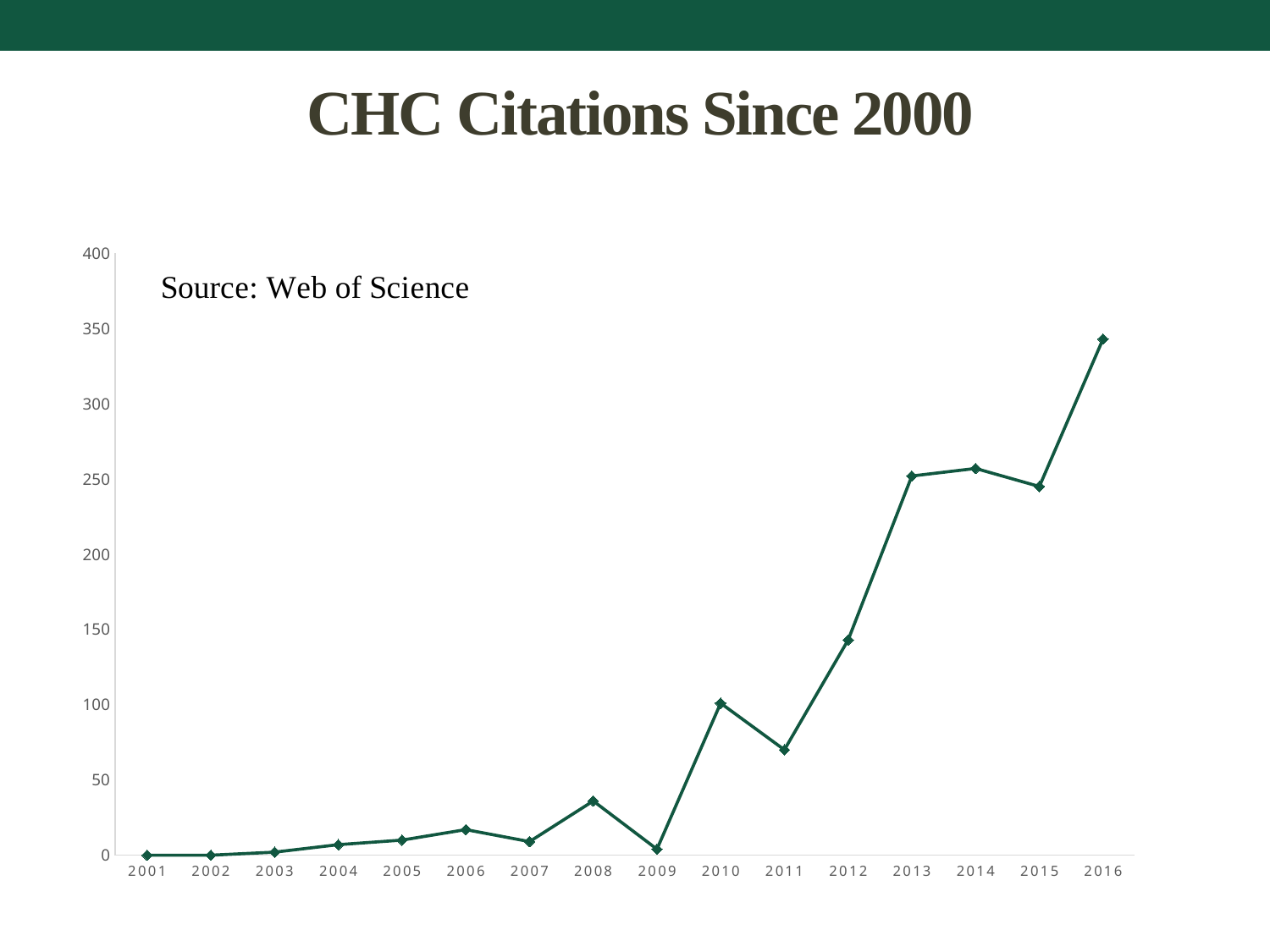
What source is cited on the chart? Web of Science Do citations generally rise or fall from 2001 to 2016? rise Is the value for 2013 greater or less than 200? greater Is the value for 2009 greater or less than 50? less How many years are plotted on the x axis? 16 Which year has more citations, 2010 or 2011? 2010 Is the value for 2011 greater or less than 100? less What kind of chart is shown on the slide? line chart Which year has the highest number of citations? 2016 What is the title of the chart? CHC Citations Since 2000